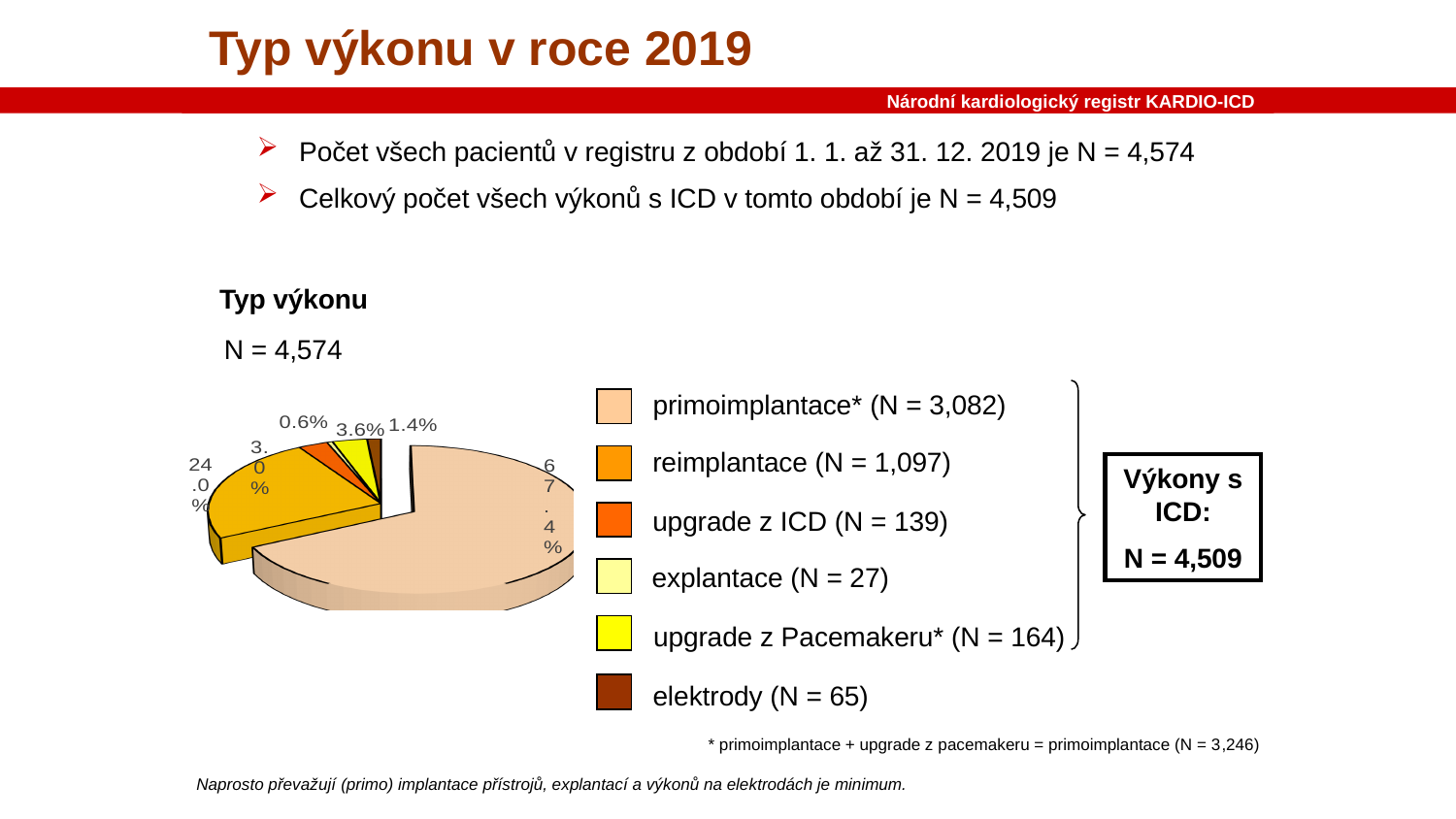
How many categories does the pie chart's legend list? 6 What percentage of the pie does reimplantace account for? 24.0% Which category has the smallest share of the pie? explantace What is the N value for reimplantace in the legend? N = 1,097 What is the difference between the N values for primoimplantace* and reimplantace? 1,985 What kind of chart is shown on the slide? pie chart Which has a larger N, upgrade z ICD or upgrade z Pacemakeru*? upgrade z Pacemakeru* Which category has the largest share of the pie? primoimplantace* What is the total N shown above the pie chart? N = 4,574 What is the N value for explantace in the legend? N = 27 What is the N value for primoimplantace* in the legend? N = 3,082 What percentage of the pie does primoimplantace* account for? 67.4%